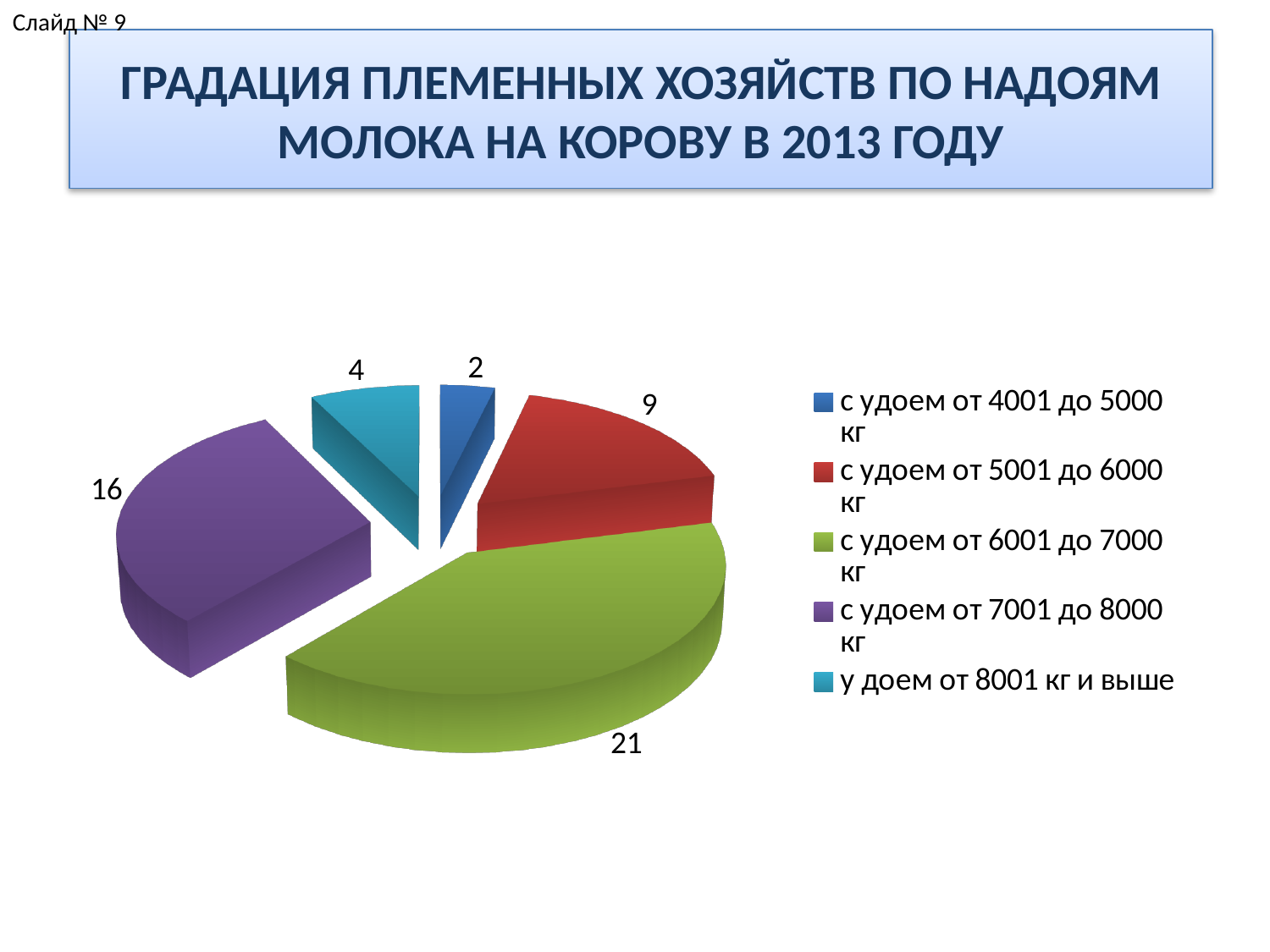
Which is larger: the value for 'с удоем от 5001 до 6000 кг' or the value for 'у доем от 8001 кг и выше'? с удоем от 5001 до 6000 кг What is the value for the category 'с удоем от 6001 до 7000 кг'? 21 What is the total of all the values shown in the pie chart? 52 What type of chart is shown on the slide? pie chart What colour is the slice for 'с удоем от 7001 до 8000 кг'? purple What is the value for the category 'у доем от 8001 кг и выше'? 4 Which category has the largest slice of the pie? с удоем от 6001 до 7000 кг How many slices does the pie chart have? 5 What is the value for the category 'с удоем от 7001 до 8000 кг'? 16 Which category has the smallest slice of the pie? с удоем от 4001 до 5000 кг What is the difference between the values for 'с удоем от 6001 до 7000 кг' and 'с удоем от 7001 до 8000 кг'? 5 What is the value for the category 'с удоем от 4001 до 5000 кг'? 2